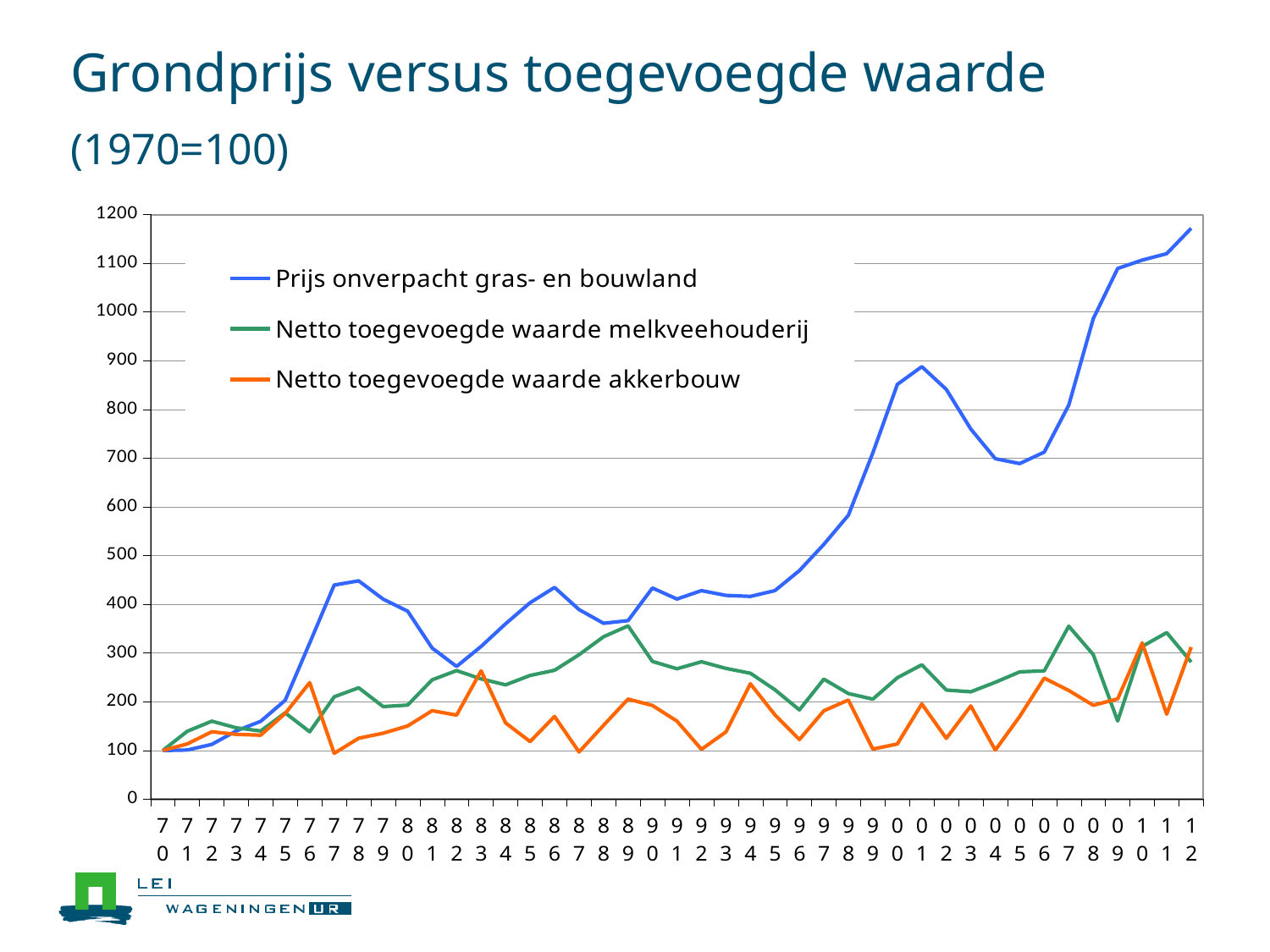
Does the Prijs onverpacht gras- en bouwland line rise or fall from 2005 to 2012? rise In 2012, which is higher: Prijs onverpacht gras- en bouwland or Netto toegevoegde waarde melkveehouderij? Prijs onverpacht gras- en bouwland In 1987, which is higher: Netto toegevoegde waarde melkveehouderij or Netto toegevoegde waarde akkerbouw? Netto toegevoegde waarde melkveehouderij Is the value for Netto toegevoegde waarde akkerbouw in 1987 greater or less than 200? less How many series does the legend list? 3 What colour is the line for Netto toegevoegde waarde akkerbouw? orange How many years are plotted along the x axis? 43 Is the value for Prijs onverpacht gras- en bouwland in 2001 greater or less than 800? greater What kind of chart is shown on the slide? line chart Is the value for Prijs onverpacht gras- en bouwland in 2012 greater or less than 1100? greater Which series reaches the highest value on the chart? Prijs onverpacht gras- en bouwland